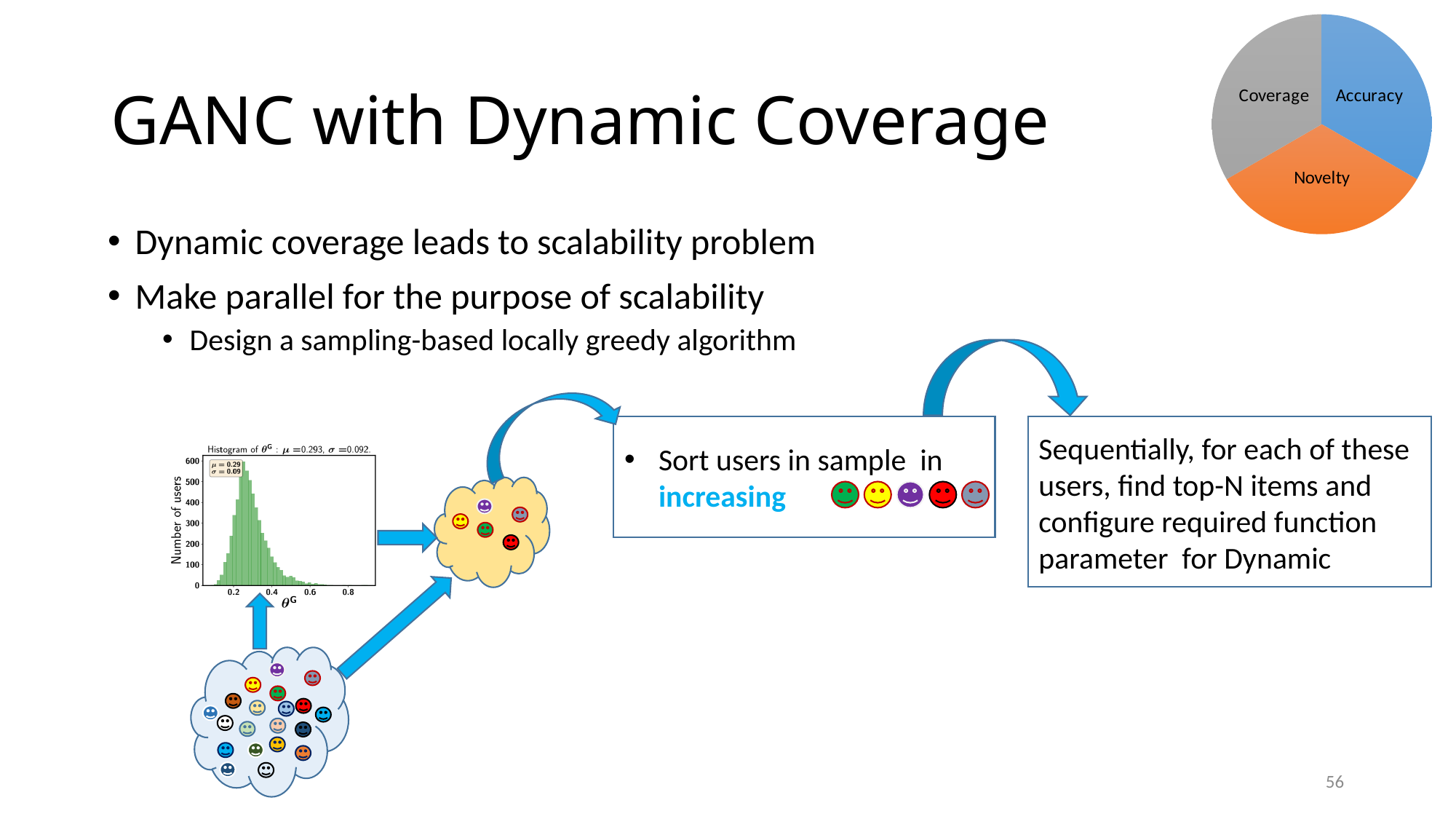
What kind of chart is shown in the top-right corner of the slide? pie chart On the histogram in the lower-left part of the slide, do the bar heights rise or fall as θ increases from 0.4 to 0.8? fall On the histogram in the lower-left part of the slide, is the bar at θ = 0.6 greater or less than 100 users? less How many slices does the pie chart in the top-right corner have? 3 On the histogram in the lower-left part of the slide, what value of σ is given in the chart title? 0.092 What is the y-axis label of the histogram in the lower-left part of the slide? Number of users On the pie chart in the top-right corner, which slice is coloured orange? Novelty What are the three slice labels on the pie chart in the top-right corner? Coverage, Accuracy, Novelty What kind of chart is the histogram in the lower-left part of the slide? bar chart On the histogram in the lower-left part of the slide, what value of μ is given in the chart title? 0.293 On the histogram in the lower-left part of the slide, is the tallest bar greater or less than 500 users? greater